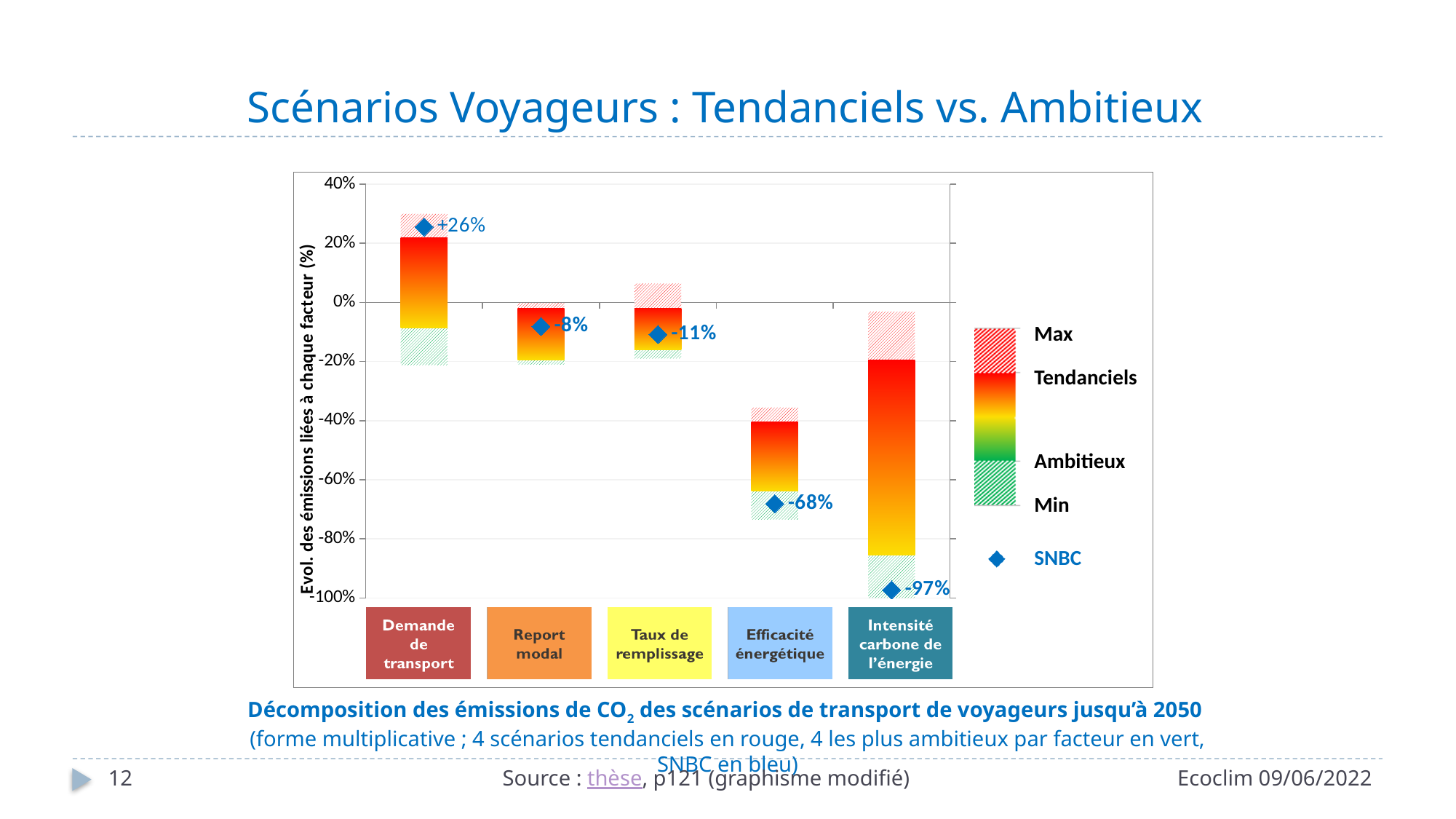
What is the difference between the SNBC values for Report modal and Taux de remplissage? 3 percentage points How many factors (categories) are shown on the x axis? 5 What is the SNBC value shown for Intensité carbone de l'énergie? -97% Which has a lower SNBC value, Efficacité énergétique or Intensité carbone de l'énergie? Intensité carbone de l'énergie How many entries does the legend list? 5 What is the label of the y axis? Evol. des émissions liées à chaque facteur (%) What is the SNBC value shown for Demande de transport? +26% Which factor has the lowest SNBC value? Intensité carbone de l'énergie What is the SNBC value shown for Efficacité énergétique? -68% What is the SNBC value shown for Report modal? -8% Which factor has the highest SNBC value? Demande de transport What is the SNBC value shown for Taux de remplissage? -11%